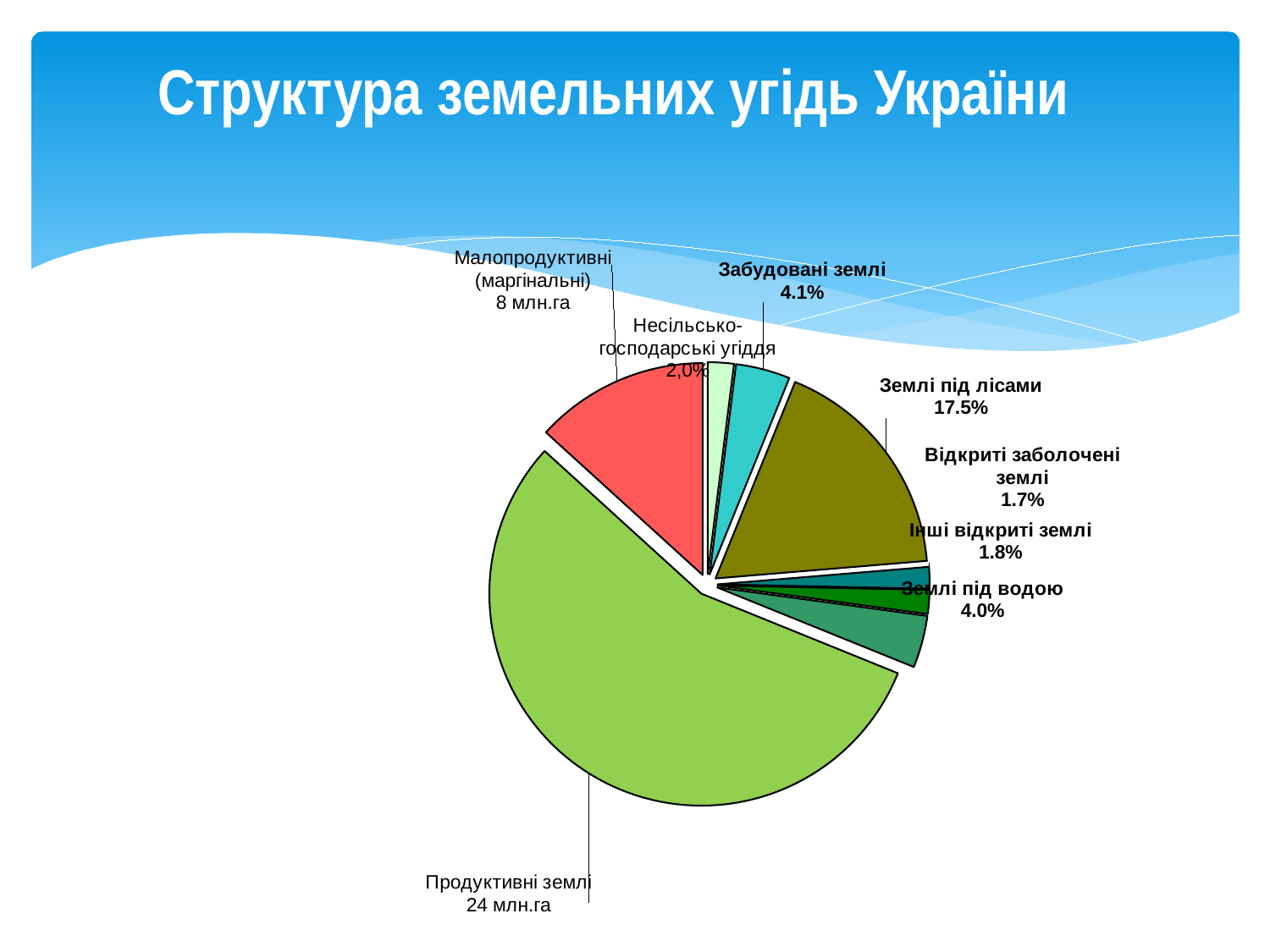
What value is shown for Продуктивні землі? 24 млн.га What value is shown for Відкриті заболочені землі? 1.7% Which is larger, Забудовані землі or Землі під водою? Забудовані землі How many slices does the pie chart have? 8 Which slice of the pie chart is the largest? Продуктивні землі What is the difference between the percentage for Землі під лісами and the percentage for Забудовані землі? 13.4% What value is shown for Малопродуктивні (маргінальні) землі? 8 млн.га What value is shown for Забудовані землі? 4.1% What kind of chart is shown on the slide? pie chart What value is shown for Землі під водою? 4.0% What value is shown for Землі під лісами? 17.5% What is the title of the chart on the slide? Структура земельних угідь України